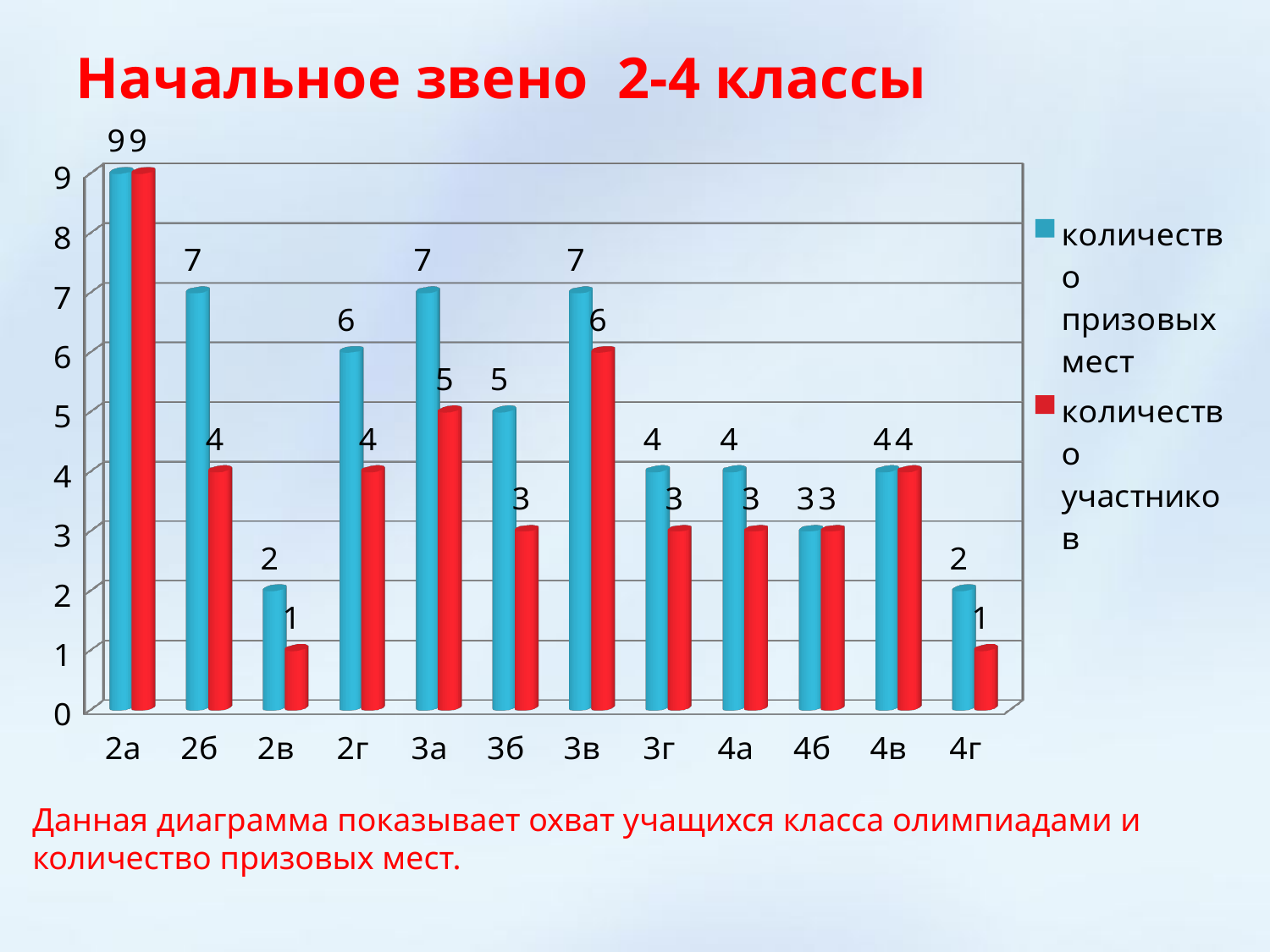
How many classes are shown on the x axis? 12 Which class has the highest value for "количество призовых мест"? 2а What is the value of "количество участников" for class 4г? 1 What is the value of "количество участников" for class 3а? 5 Which is larger for class 3в: "количество призовых мест" or "количество участников"? количество призовых мест What type of chart is shown on the slide? Bar chart Which class has the lowest value for "количество призовых мест"? 2в and 4г (both 2) Which colour represents "количество участников" in the legend? Red What is the title of the slide? Начальное звено 2-4 классы What is the difference between "количество призовых мест" and "количество участников" for class 2б? 3 How many series does the legend list? 2 What is the value of "количество призовых мест" for class 2б? 7